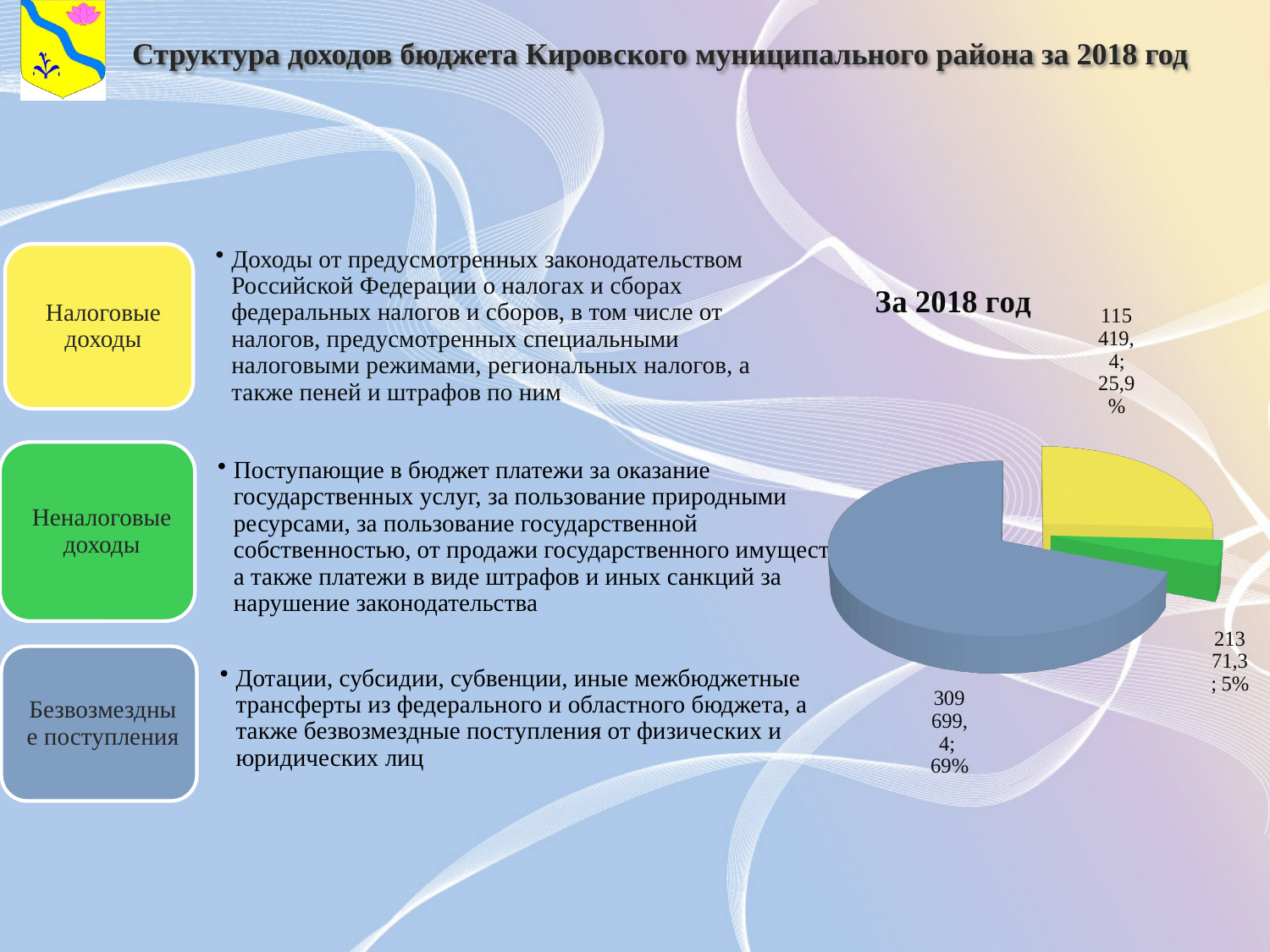
What value is labelled on the yellow slice of the pie chart? 115 419,4 Which slice of the pie chart is the largest? the blue slice (69%) What kind of chart is shown on the slide? pie chart What value is labelled on the blue slice of the pie chart? 309 699,4 What share of the pie does the blue slice represent? 69% What is the title of the pie chart? За 2018 год What share of the pie does the yellow slice represent? 25,9% What is the difference in percentage points between the blue slice's share and the yellow slice's share? 43,1% Which is larger, the yellow slice or the green slice? the yellow slice Which slice of the pie chart is the smallest? the green slice (5%) What share of the pie does the green slice represent? 5% How many slices does the pie chart have? 3